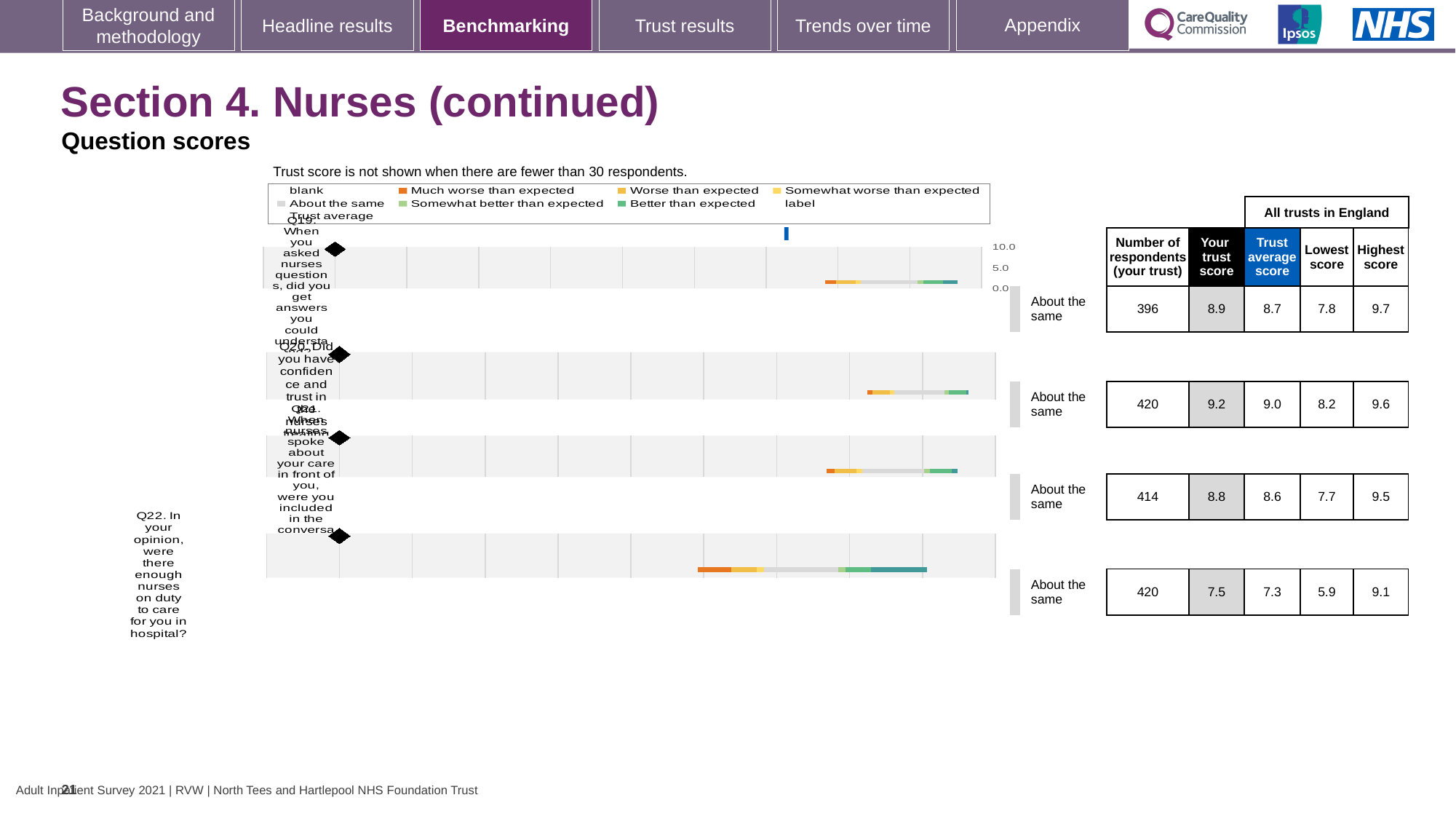
How many respondents from your trust answered Q19 (answers you could understand)? 396 What kind of chart is used to show the question scores? Bar chart What benchmark category is shown for each of the four questions? About the same What is the highest score across all trusts in England for Q20 (confidence and trust in nurses)? 9.6 Is the trust score for Q22 greater or less than 5.0? greater How many questions are plotted on the chart? 4 For Q19, which is larger: your trust score or the trust average score? Your trust score Which question has the highest 'Your trust score'? Q20 Which question has the lowest 'Your trust score'? Q22 What is the lowest score across all trusts in England for Q22? 5.9 What is the 'Your trust score' for Q22 (enough nurses on duty)? 7.5 What is the difference between your trust score and the trust average score for Q22? 0.2